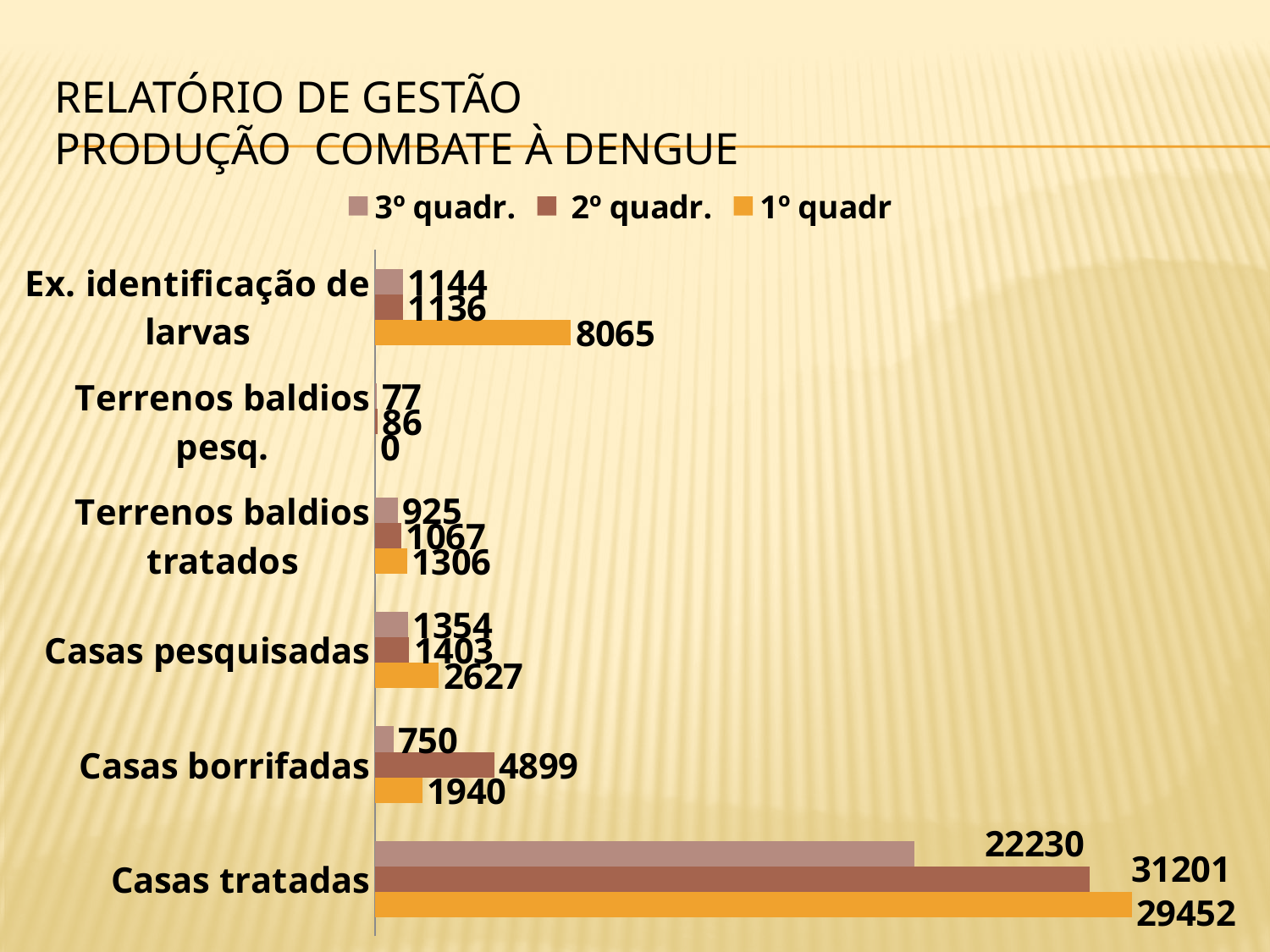
What is the value for Terrenos baldios pesq. in the 3º quadr. series? 77 Which category has the highest value in the 2º quadr. series? Casas tratadas How many categories are shown on the chart? 6 What kind of chart is shown on the slide? Bar chart For Casas borrifadas, which is larger: the 2º quadr. value or the 1º quadr value? 2º quadr. What is the difference between the 2º quadr. and 1º quadr values for Casas tratadas? 1749 How many series does the legend list? 3 What is the value for Casas tratadas in the 1º quadr series? 29452 What is the value for Casas borrifadas in the 2º quadr. series? 4899 Which category has the lowest value in the 1º quadr series? Terrenos baldios pesq. What is the value for Ex. identificação de larvas in the 1º quadr series? 8065 What is the difference between the 1º quadr and 3º quadr. values for Casas pesquisadas? 1273